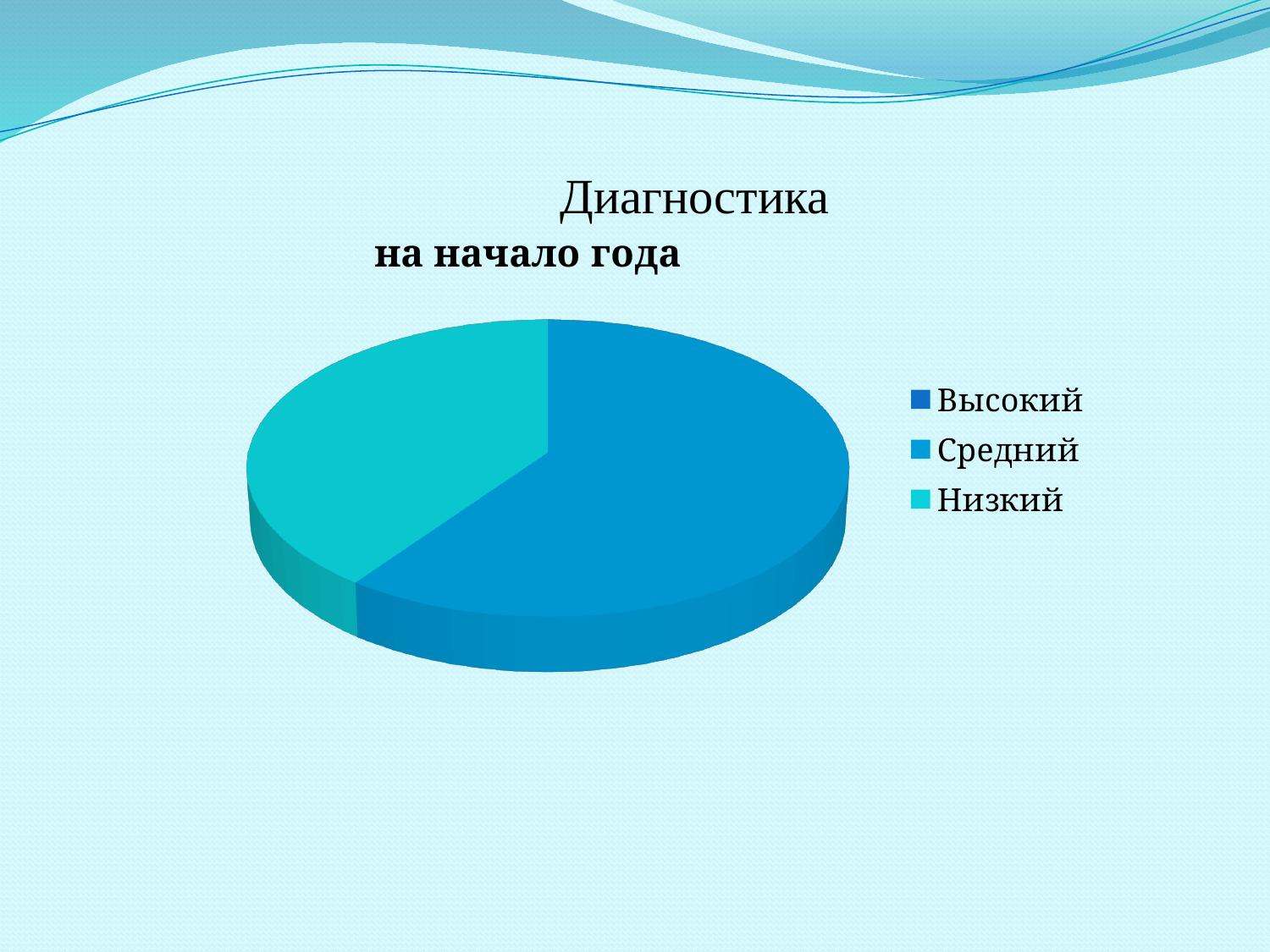
Which slice is larger, Средний or Низкий? Средний Which category has the largest slice in the pie chart? Средний What is the title of the chart on the slide? на начало года Is the share of the Низкий slice greater or less than 50%? less How many entries does the legend of the pie chart list? 3 What kind of chart is shown on the slide? pie chart Which legend entry is shown in the lightest (teal) colour? Низкий Is the share of the Средний slice greater or less than 50%? greater